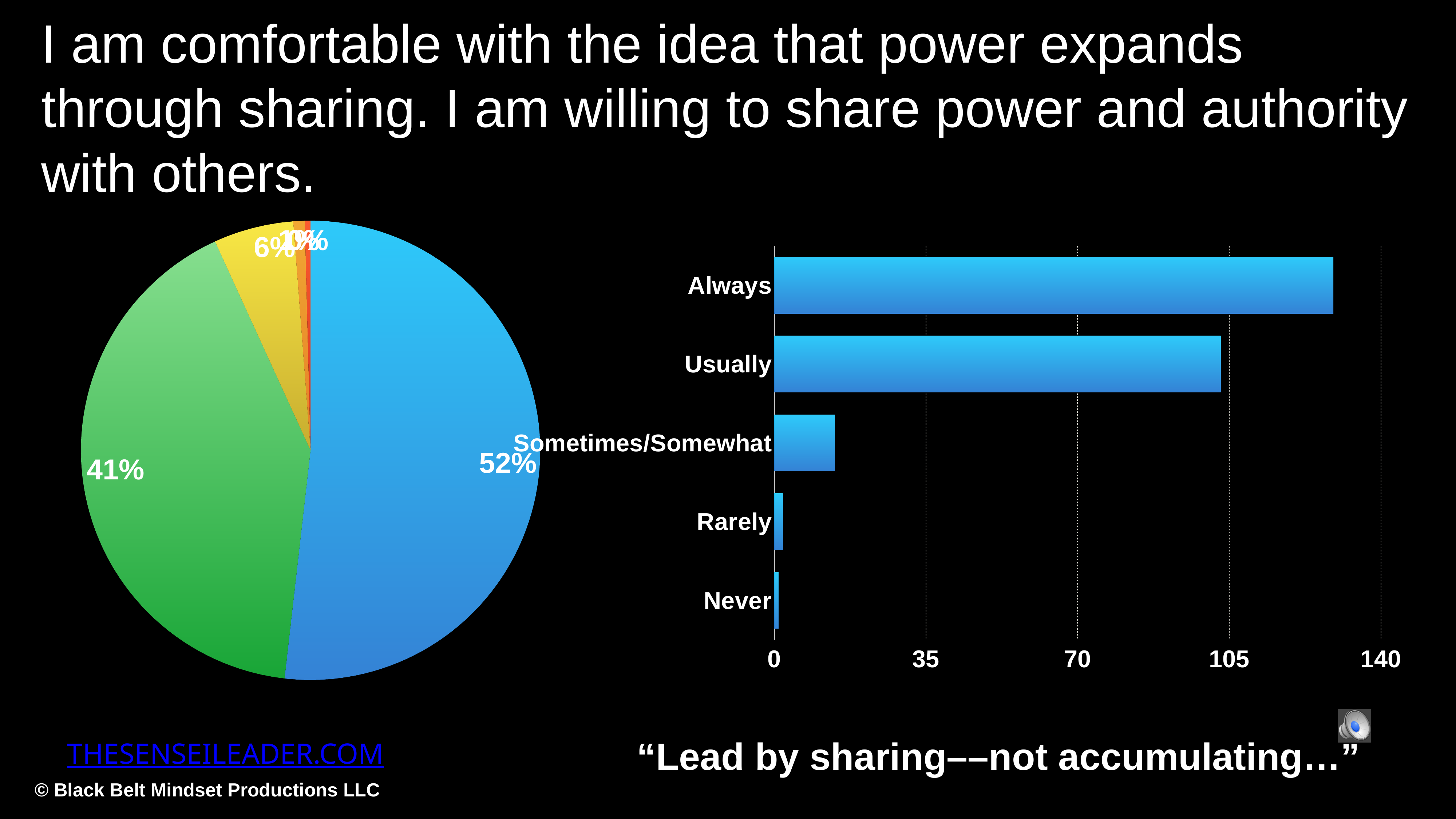
In the bar chart on the right, how many categories are shown? 5 In the bar chart on the right, is the value for Usually greater or less than 70? greater In the bar chart on the right, which is larger, the value for Sometimes/Somewhat or the value for Usually? Usually What kind of chart is the chart on the left of the slide? pie chart In the bar chart on the right, which is larger, the value for Always or the value for Usually? Always In the bar chart on the right, is the value for Rarely greater or less than 35? less What kind of chart is the chart on the right of the slide? bar chart In the pie chart on the left, what share does the largest slice have? 52% In the bar chart on the right, is the value for Always greater or less than 105? greater In the pie chart on the left, what share does the green slice have? 41% In the bar chart on the right, which category has the highest value? Always